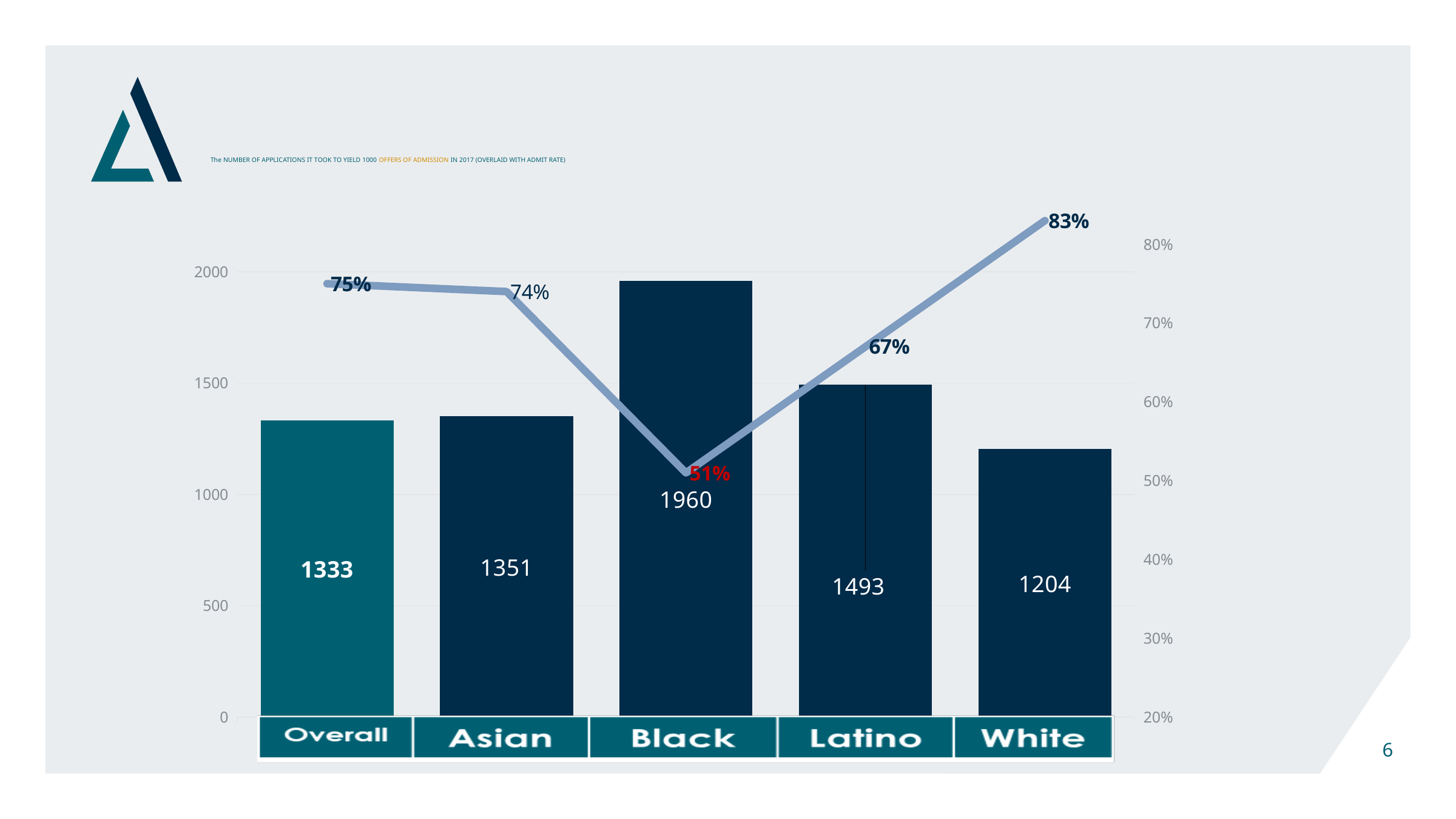
Which category has the lowest number of applications per 1000 offers? White What is the difference between the number of applications for Black and for White applicants? 756 What is the admit rate shown for Asian applicants? 74% What is the difference between the admit rate for White and for Latino applicants? 16% What kind of chart is this? Combined bar and line chart Which category has the highest number of applications per 1000 offers? Black Which category has the lowest admit rate on the line? Black What is the admit rate shown for White applicants? 83% How many categories are shown on the x axis? 5 What is the number of applications shown for the Overall category? 1333 How many applications did it take to yield 1000 offers of admission for Black applicants? 1960 Which is larger, the number of applications for Latino or for Asian applicants? Latino